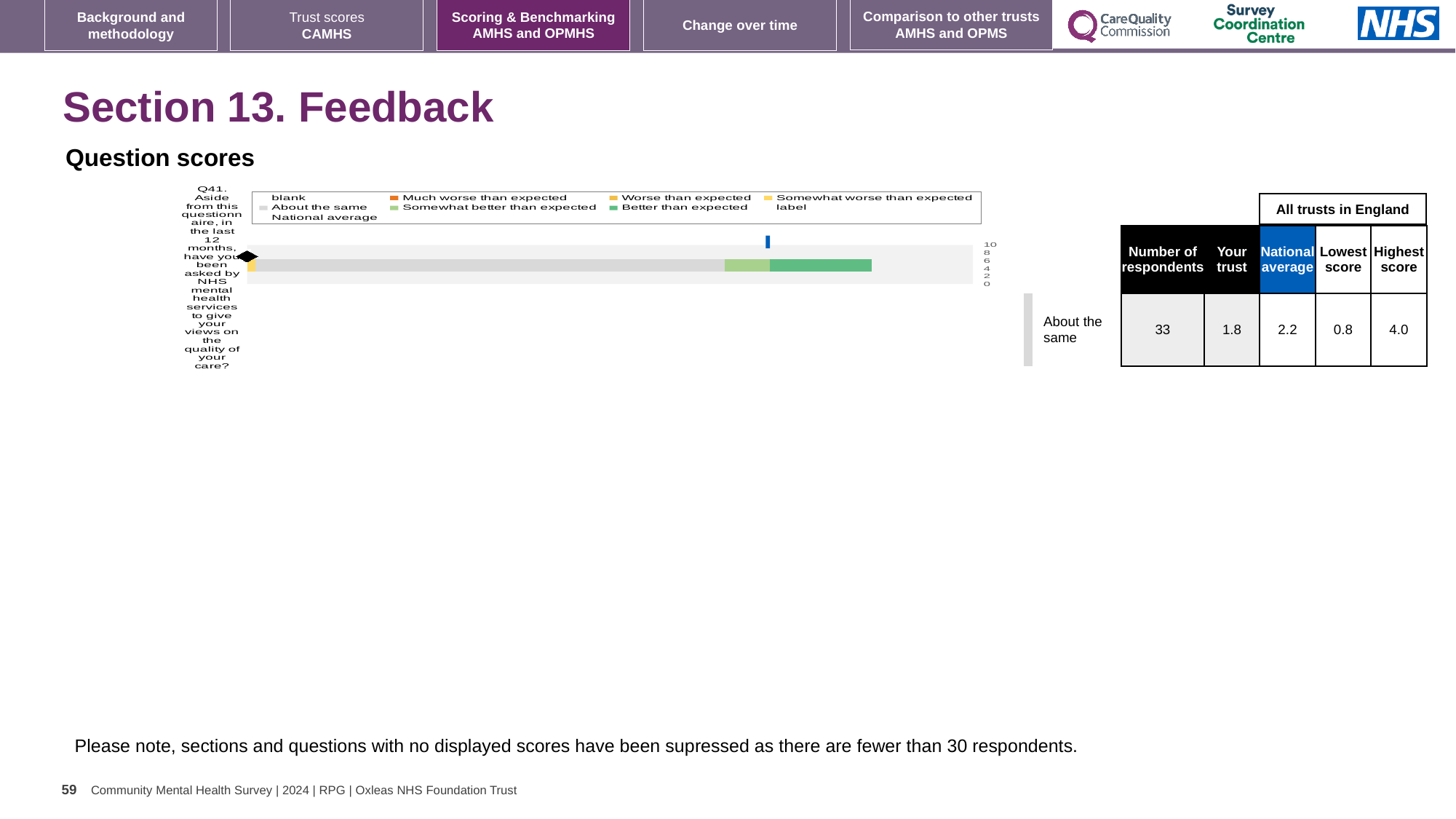
What is the highest score among all trusts in England for Q41? 4.0 What is the lowest score among all trusts in England for Q41? 0.8 Which is larger for Q41, the 'Your trust' score or the national average? National average Which benchmark category is the trust's Q41 score placed in? About the same What is the highest value shown on the chart's axis? 10 How many respondents answered Q41? 33 How many survey questions are plotted in the chart? 1 What is the difference between the highest score and the lowest score for Q41? 3.2 What is the national average score for Q41? 2.2 What is the 'Your trust' score for Q41? 1.8 What kind of chart is shown on the slide? bar chart Which question number is plotted in the chart? Q41